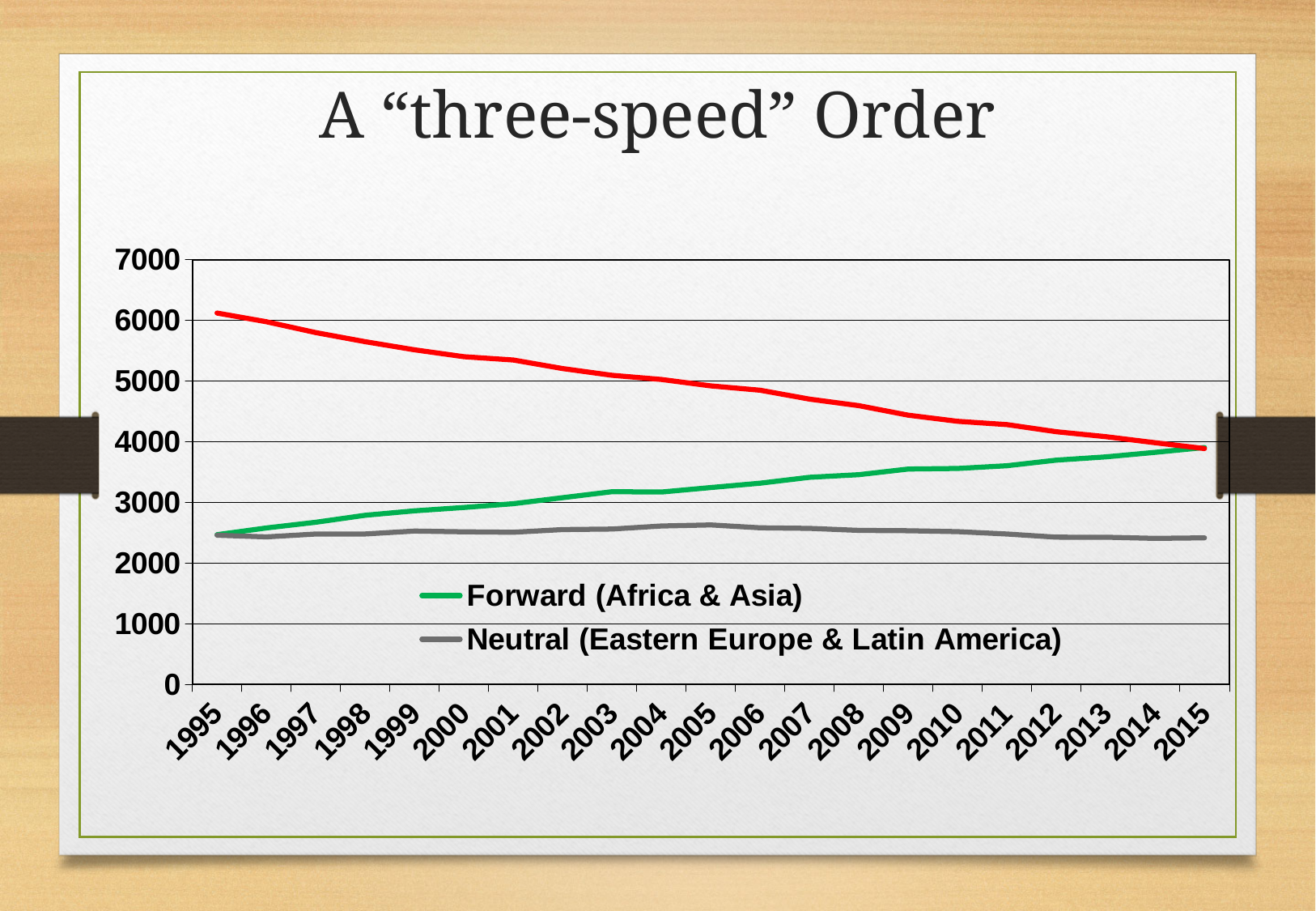
Is the value for Forward (Africa & Asia) in 2010 greater or less than 4000? less Is the value for Forward (Africa & Asia) in 2015 greater or less than 3000? greater How many series does the chart's legend list? 2 How many years are shown along the x axis of the chart? 21 Does the Forward (Africa & Asia) line rise or fall from 1995 to 2015? rise In 2015, which is larger: Forward (Africa & Asia) or Neutral (Eastern Europe & Latin America)? Forward (Africa & Asia) Is the value for Neutral (Eastern Europe & Latin America) in 2005 greater or less than 2000? greater What kind of chart is shown on the slide? line chart What is the title of the slide containing the chart? A "three-speed" Order What colour is the line for Forward (Africa & Asia)? green